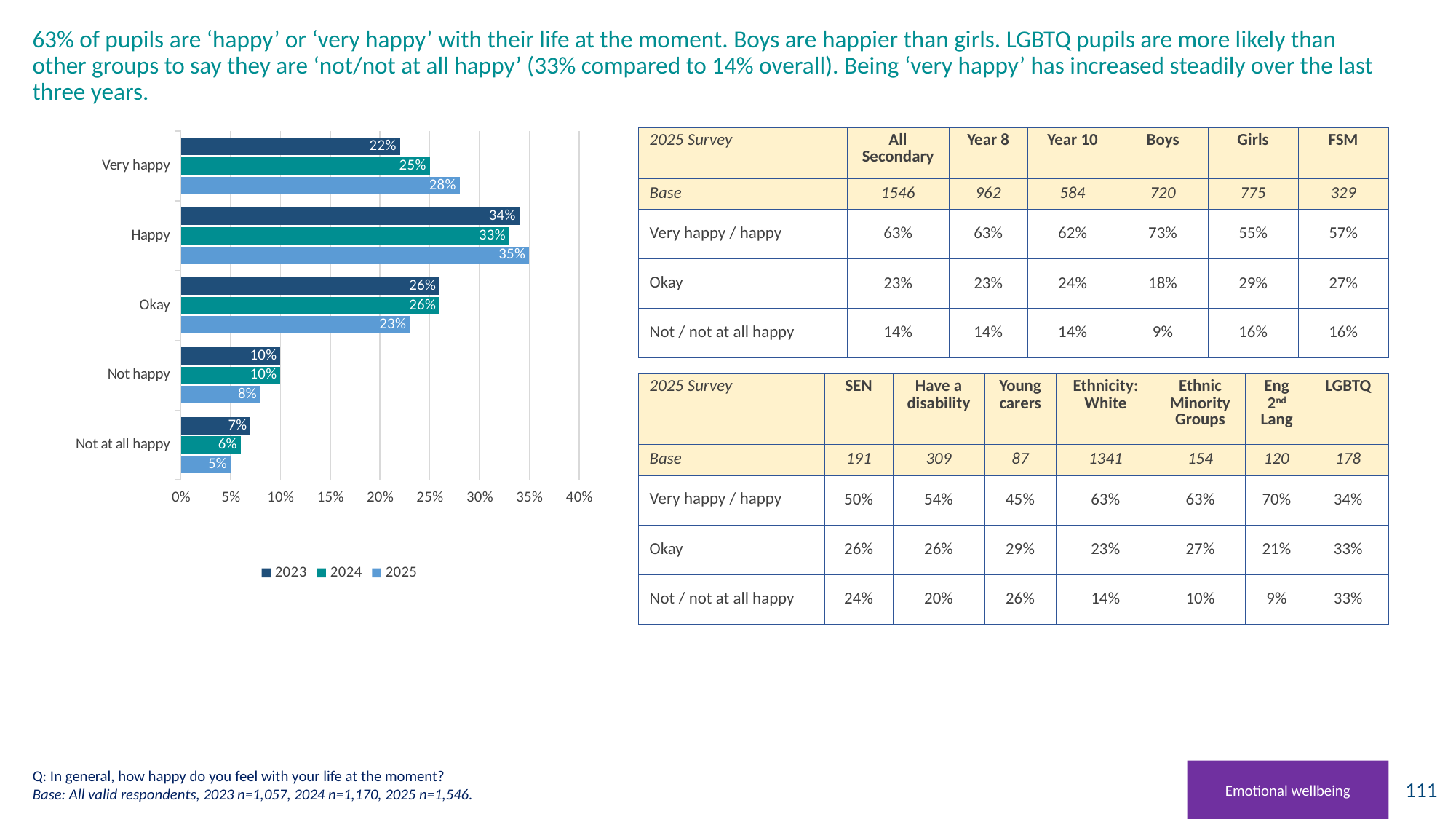
What is the 2024 value for 'Not at all happy'? 6% What kind of chart is shown on the slide? Bar chart Which is larger: the 2024 value for 'Okay' or the 2025 value for 'Okay'? 2024 Which series is shown in the darkest blue colour in the legend? 2023 What is the 2023 value for 'Happy'? 34% Which category has the highest 2025 value? Happy What is the difference between the 2025 and 2023 values for 'Very happy'? 6% How many series does the legend list? 3 What is the 2025 value for 'Very happy'? 28% How many categories are shown on the chart? 5 Which category has the lowest 2023 value? Not at all happy Is the 2025 value for 'Happy' greater or less than 30%? greater